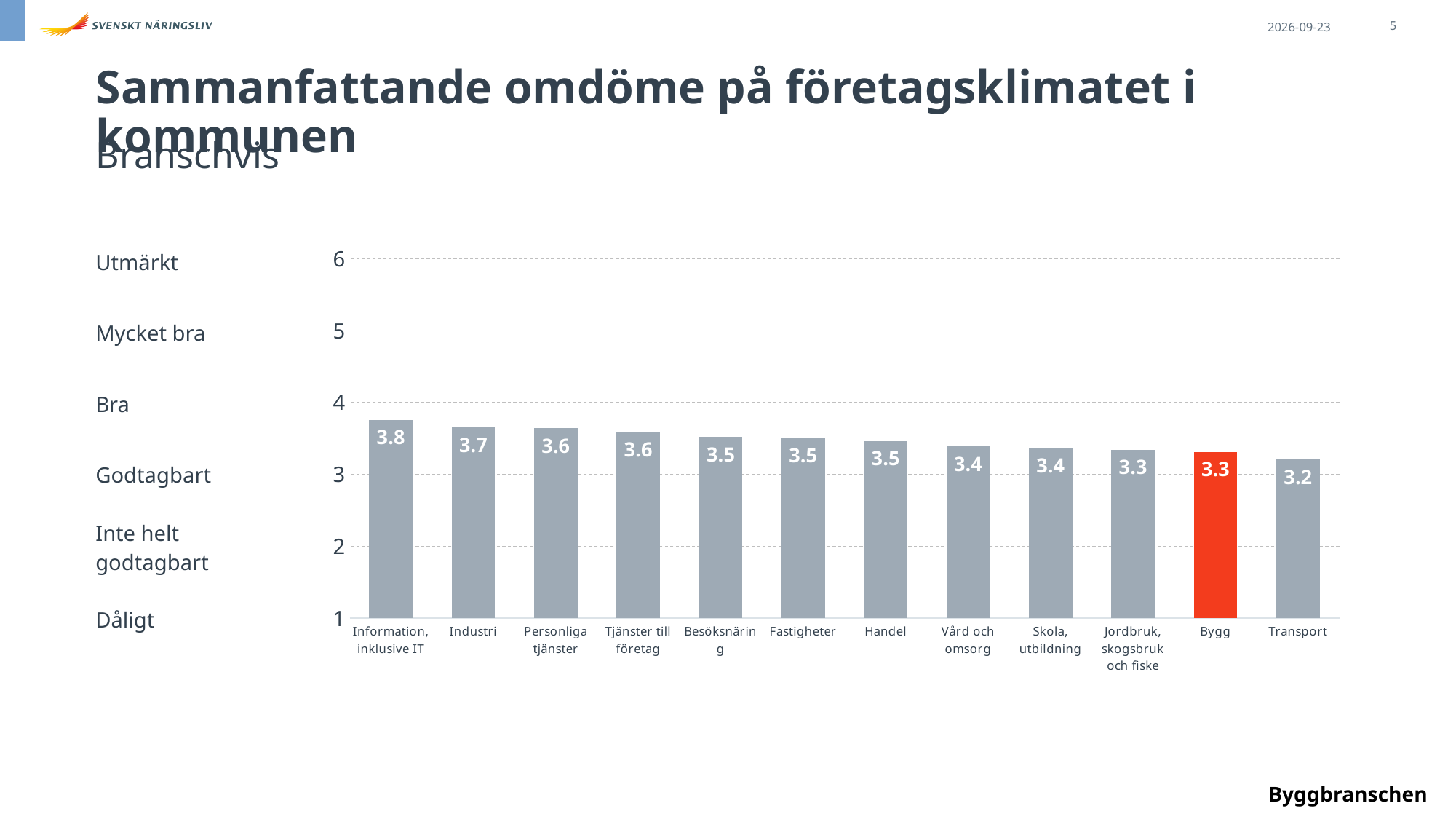
What is the difference between the values for Information, inklusive IT and Transport? 0.6 Which category has the lowest value? Transport What is the value for Information, inklusive IT? 3.8 Is the value for Bygg greater or less than 4? less Which category has the highest value? Information, inklusive IT Which is larger, the value for Industri or the value for Bygg? Industri Which bar is highlighted in red? Bygg What is the value for Transport? 3.2 How many categories are shown on the x axis? 12 What kind of chart is shown on the slide? bar chart What is the value for Handel? 3.5 What is the value for Bygg? 3.3